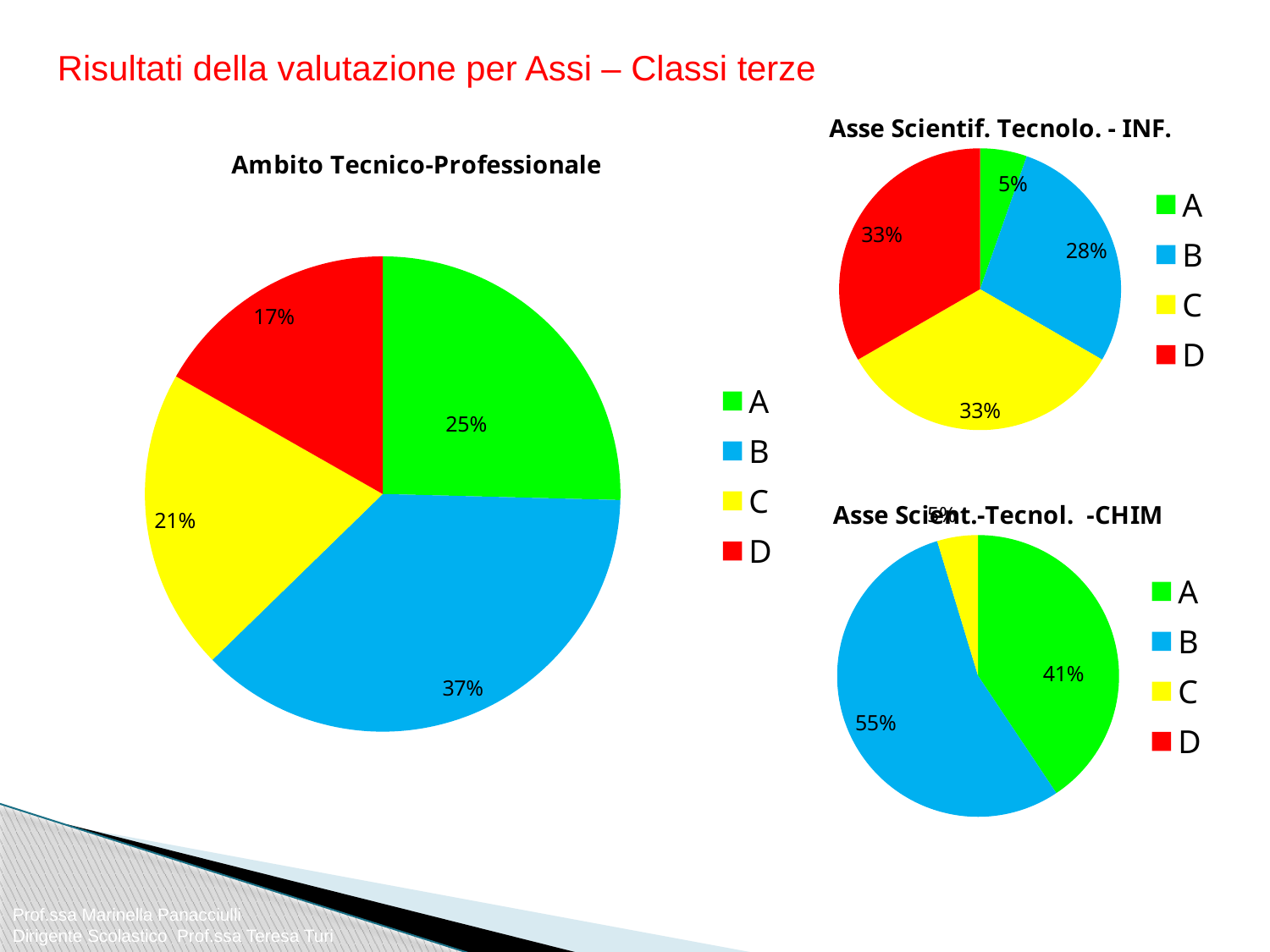
In the 'Ambito Tecnico-Professionale' chart, which category has the largest share? B In the 'Asse Scient.-Tecnol. -CHIM' chart, which category has the largest share? B In the 'Ambito Tecnico-Professionale' chart, what is the difference between the shares of A and D? 8% In the 'Ambito Tecnico-Professionale' chart, which category has the smallest share? D In the 'Asse Scientif. Tecnolo. - INF.' chart, what share does category B have? 28% In the 'Ambito Tecnico-Professionale' chart, what share does category B have? 37% In the 'Asse Scient.-Tecnol. -CHIM' chart, what is the difference between the shares of B and A? 14% In the 'Asse Scientif. Tecnolo. - INF.' chart, which is larger, the share of B or the share of C? C In the 'Asse Scient.-Tecnol. -CHIM' chart, what share does category B have? 55% How many entries does the legend of the 'Ambito Tecnico-Professionale' chart list? 4 In the 'Asse Scientif. Tecnolo. - INF.' chart, which category has the smallest share? A In the 'Ambito Tecnico-Professionale' chart, what kind of chart is shown? Pie chart